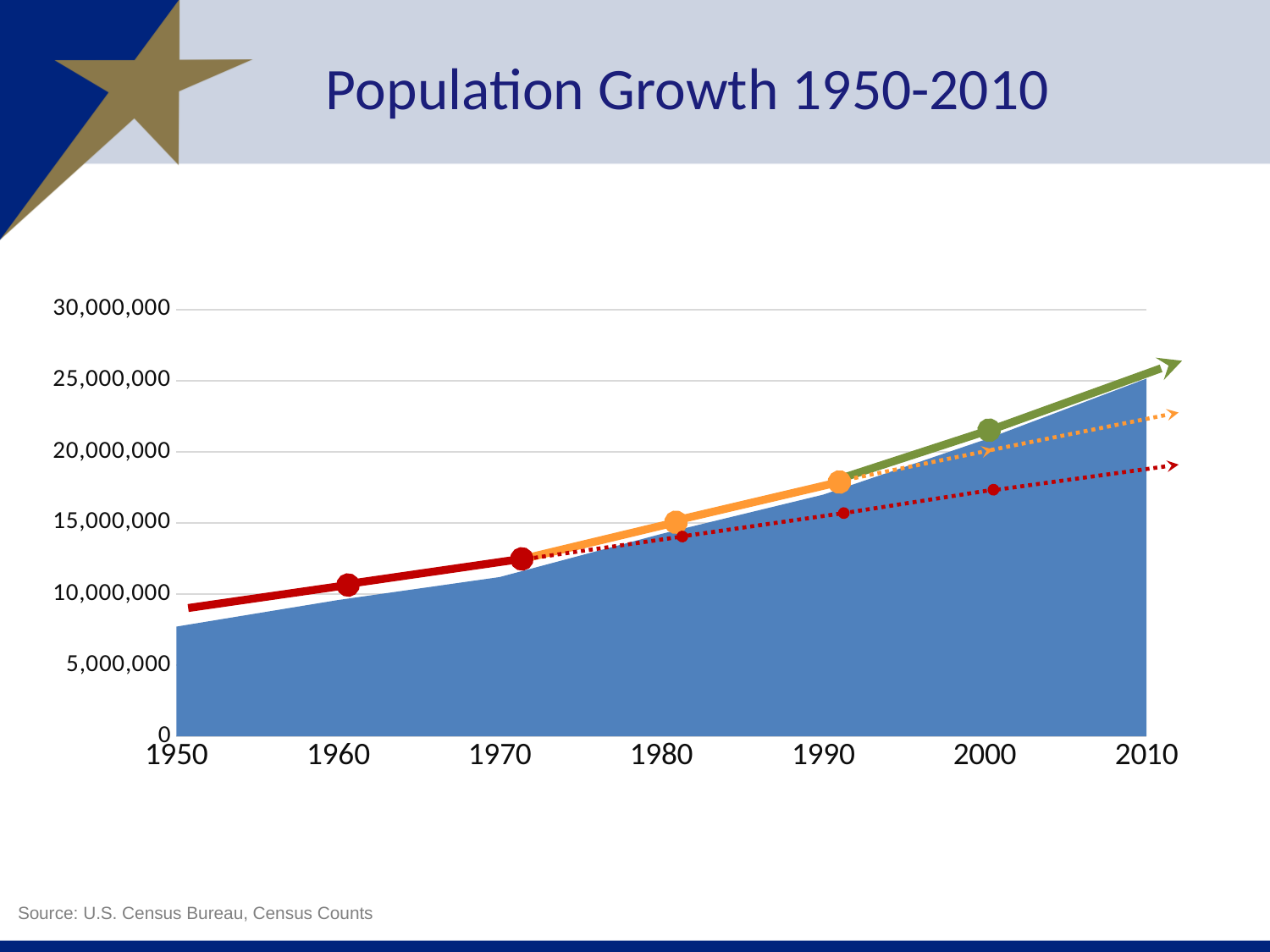
What kind of chart is shown on the slide? area chart Is the population value for 1980 greater or less than 10,000,000? greater Which year has the lowest population value? 1950 How many years are labelled on the x axis? 7 Is the population value for 1990 greater or less than 15,000,000? greater Which year has the larger population value, 1970 or 2000? 2000 What is the title of the chart? Population Growth 1950-2010 Which year has the highest population value? 2010 What source is cited for the chart data? U.S. Census Bureau, Census Counts Is the population value for 2010 greater or less than 20,000,000? greater Does the population rise or fall from 1950 to 2010? rise